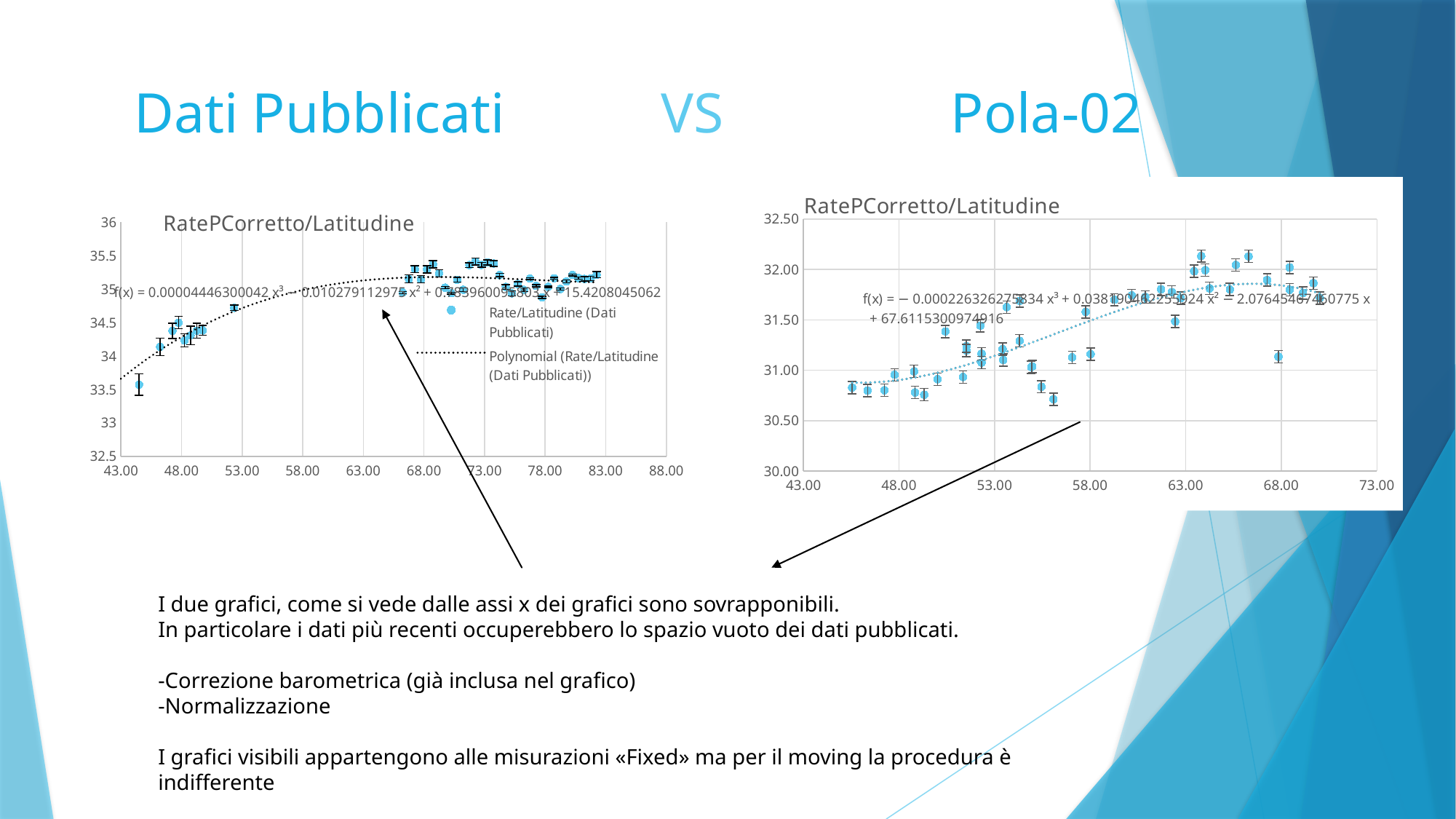
What is the largest value shown on the x axis of the right chart? 73.00 What is the title of the left chart? RatePCorretto/Latitudine On the right chart, is the highest plotted value greater or less than 32.00? greater On the left chart, is the lowest plotted value greater or less than 34? less How many entries does the legend of the left chart list? 2 What kind of chart is the left chart on the slide? scatter chart On the right chart, is the rightmost data point higher or lower than the leftmost data point? higher On the right chart, do the plotted values overall rise or fall as the x-axis value increases? rise On the right chart, is the lowest plotted value greater or less than 31.00? less On the left chart, is the leftmost data point higher or lower than the rightmost data point? lower On the left chart, do the plotted values overall rise or fall as the x-axis value increases? rise What kind of chart is the right chart on the slide? scatter chart